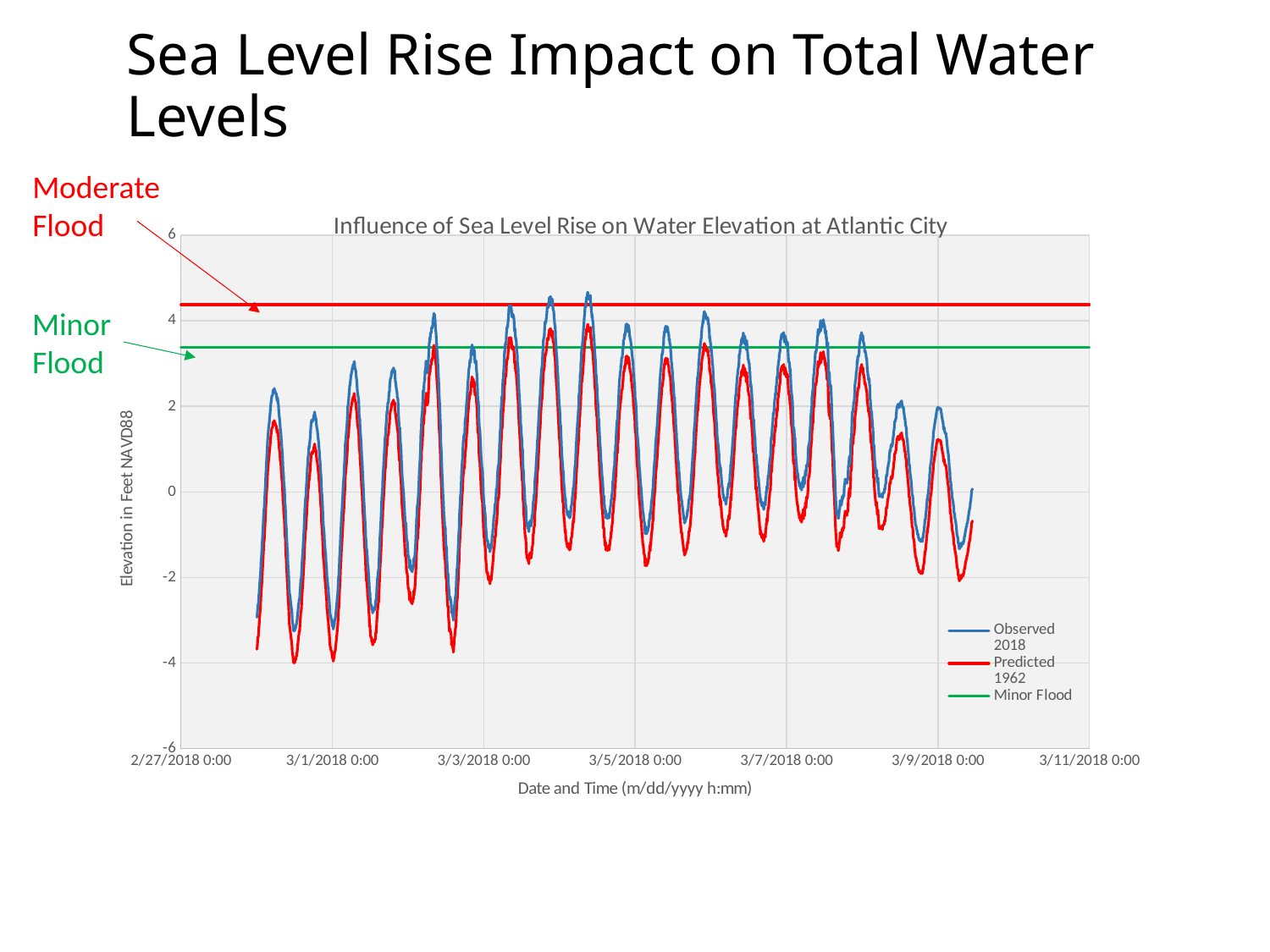
Which series reaches higher peaks, Observed 2018 or Predicted 1962? Observed 2018 Is the Minor Flood line greater or less than 2 feet? greater What is the label of the vertical axis? Elevation in Feet NAVD88 What is the title of the chart? Influence of Sea Level Rise on Water Elevation at Atlantic City Is the highest peak of the Observed 2018 series greater or less than 4 feet? greater Is the highest peak of the Predicted 1962 series greater or less than 2 feet? greater What kind of chart is shown on the slide? line chart How many series does the chart legend list? 3 Which series has the lower troughs, Observed 2018 or Predicted 1962? Predicted 1962